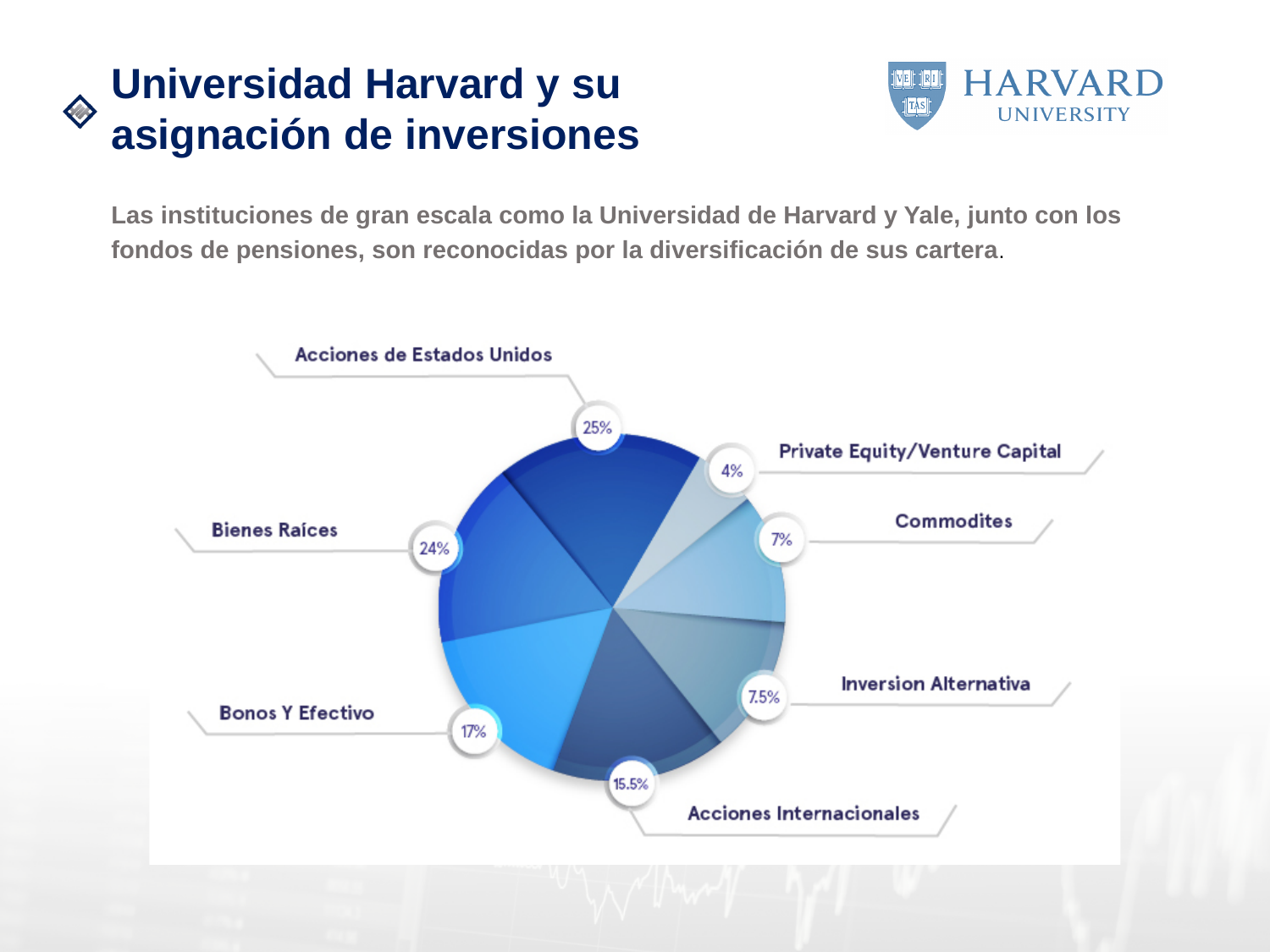
What is the difference between the shares of Bonos Y Efectivo and Commodites? 10% Which is larger, the share for Inversion Alternativa or the share for Commodites? Inversion Alternativa Which category has the largest share of the pie chart? Acciones de Estados Unidos What percentage is shown for Private Equity/Venture Capital? 4% What is the value shown for Acciones Internacionales? 15.5% How many categories are shown in the pie chart? 7 What is the combined share of Acciones de Estados Unidos and Bienes Raíces? 49% What type of chart is shown on the slide? Pie chart What percentage of the portfolio is allocated to Acciones de Estados Unidos? 25% What share does Bienes Raíces have in the pie chart? 24% What is the value for Inversion Alternativa? 7.5% Which category has the smallest share of the pie chart? Private Equity/Venture Capital